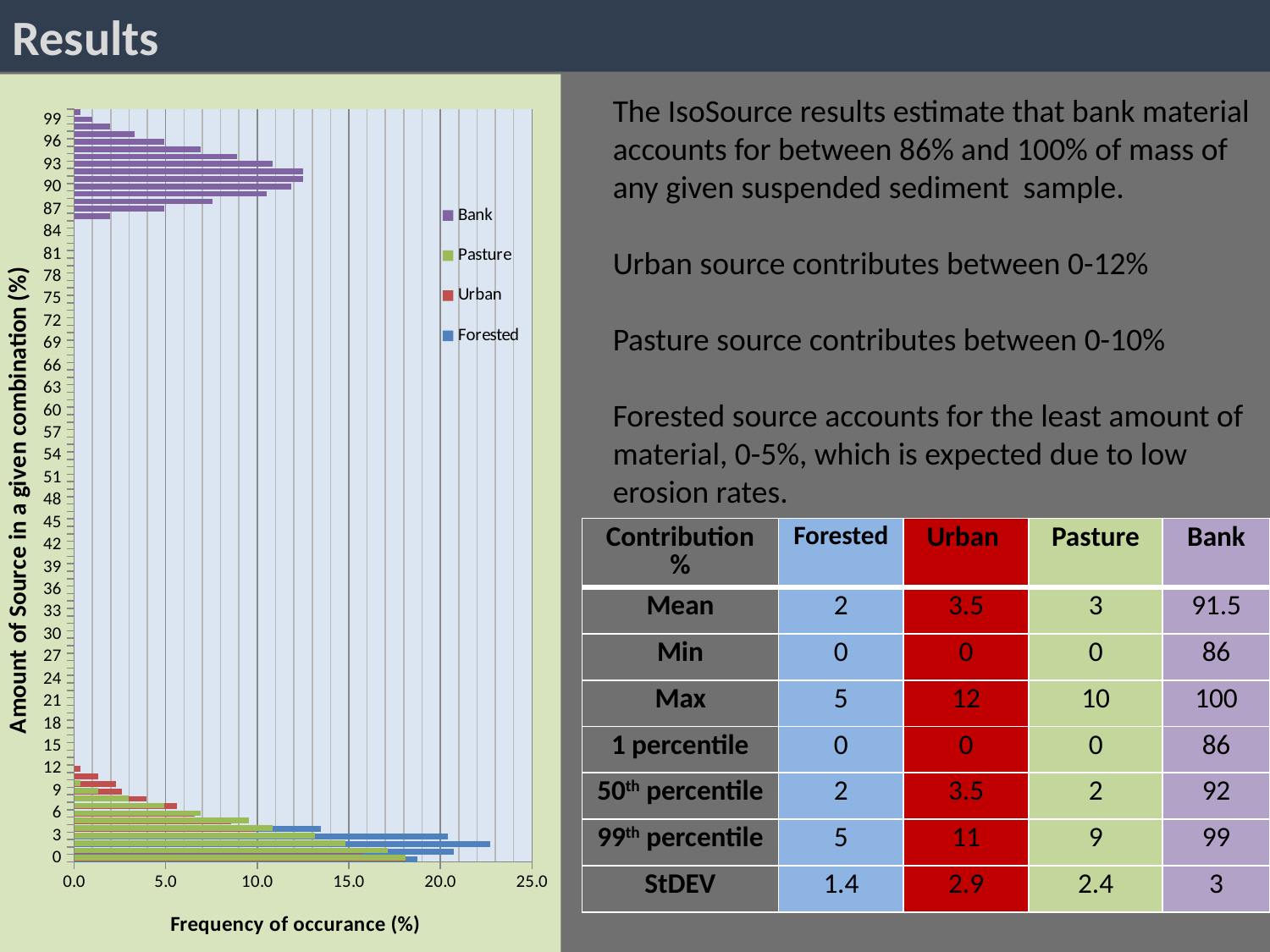
Which series has its bars located at the highest values on the y axis (around 86 to 100)? Bank What is the title of the chart's x axis? Frequency of occurance (%) How many series does the chart's legend list? 4 Is the longest Urban bar greater or less than 10.0 on the x axis? greater What are the series names listed in the chart's legend? Bank, Pasture, Urban, Forested What kind of chart is shown on the slide? bar chart Is the longest Bank bar longer or shorter than the longest Forested bar? shorter Is the longest Bank bar greater or less than 10.0 on the x axis? greater Which series has the longest bar in the chart? Forested Is the longest Forested bar greater or less than 20.0 on the x axis? greater What is the maximum value shown on the chart's x axis? 25.0